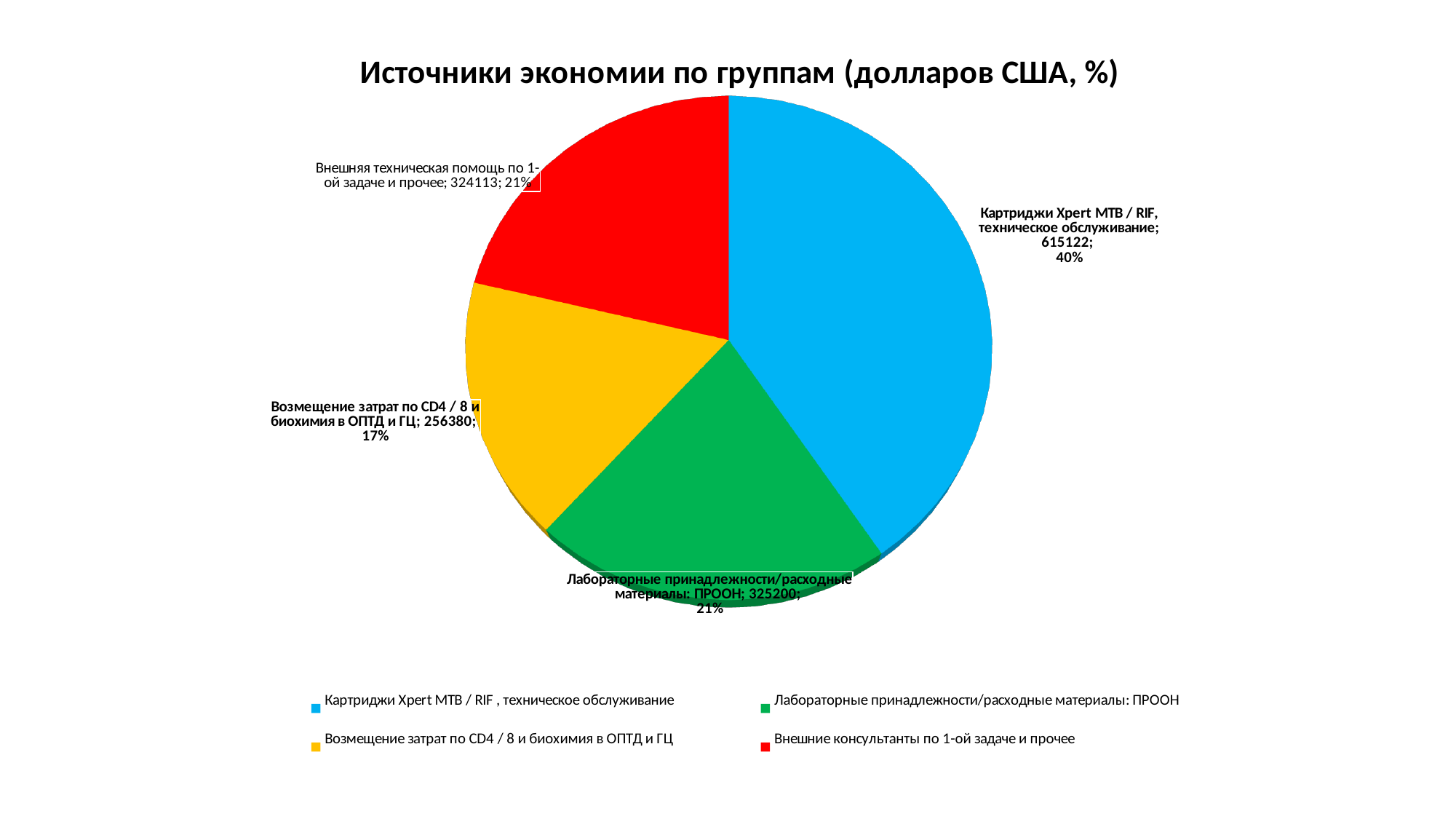
What share of the pie does Возмещение затрат по CD4 / 8 и биохимия в ОПТД и ГЦ represent? 17% Which is larger: the value for Картриджи Xpert MTB / RIF, техническое обслуживание or the value for Лабораторные принадлежности/расходные материалы: ПРООН? Картриджи Xpert MTB / RIF, техническое обслуживание How many slices does the pie chart have? 4 What kind of chart is shown on the slide? pie chart Which category has the smallest slice? Возмещение затрат по CD4 / 8 и биохимия в ОПТД и ГЦ Which category has the largest slice? Картриджи Xpert MTB / RIF, техническое обслуживание What is the value for Картриджи Xpert MTB / RIF, техническое обслуживание? 615122 What is the title of the chart? Источники экономии по группам (долларов США, %) What colour is the slice for Возмещение затрат по CD4 / 8 и биохимия в ОПТД и ГЦ? yellow What is the difference between the values for Картриджи Xpert MTB / RIF, техническое обслуживание and Возмещение затрат по CD4 / 8 и биохимия в ОПТД и ГЦ? 358742 What is the value for Внешняя техническая помощь по 1-ой задаче и прочее? 324113 What is the value for Лабораторные принадлежности/расходные материалы: ПРООН? 325200